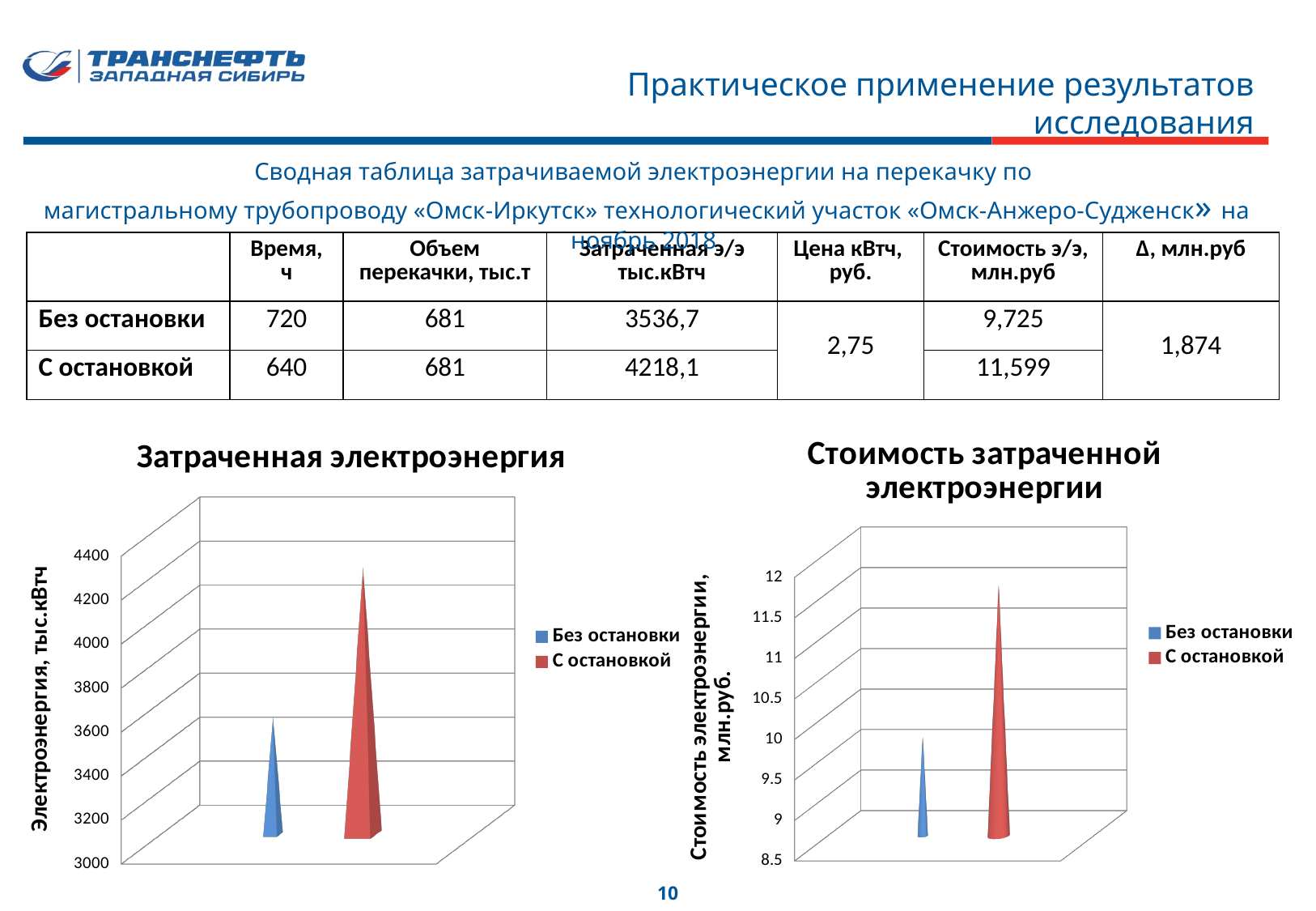
How many series does the legend of the left chart 'Затраченная электроэнергия' list? 2 In the left chart 'Затраченная электроэнергия', what colour represents the series 'С остановкой'? red What is the y-axis label of the right chart 'Стоимость затраченной электроэнергии'? Стоимость электроэнергии, млн.руб. In the left chart 'Затраченная электроэнергия', which series has the higher value? С остановкой In the left chart 'Затраченная электроэнергия', is the value for 'С остановкой' greater or less than 4000? greater In the right chart 'Стоимость затраченной электроэнергии', is the value for 'С остановкой' greater or less than 11? greater In the left chart 'Затраченная электроэнергия', is the value for 'Без остановки' greater or less than 4000? less In the right chart 'Стоимость затраченной электроэнергии', is the value for 'Без остановки' larger or smaller than the value for 'С остановкой'? smaller In the right chart 'Стоимость затраченной электроэнергии', which series has the higher value? С остановкой What kind of chart is the right chart 'Стоимость затраченной электроэнергии'? bar chart In the left chart 'Затраченная электроэнергия', which series has the lower value? Без остановки